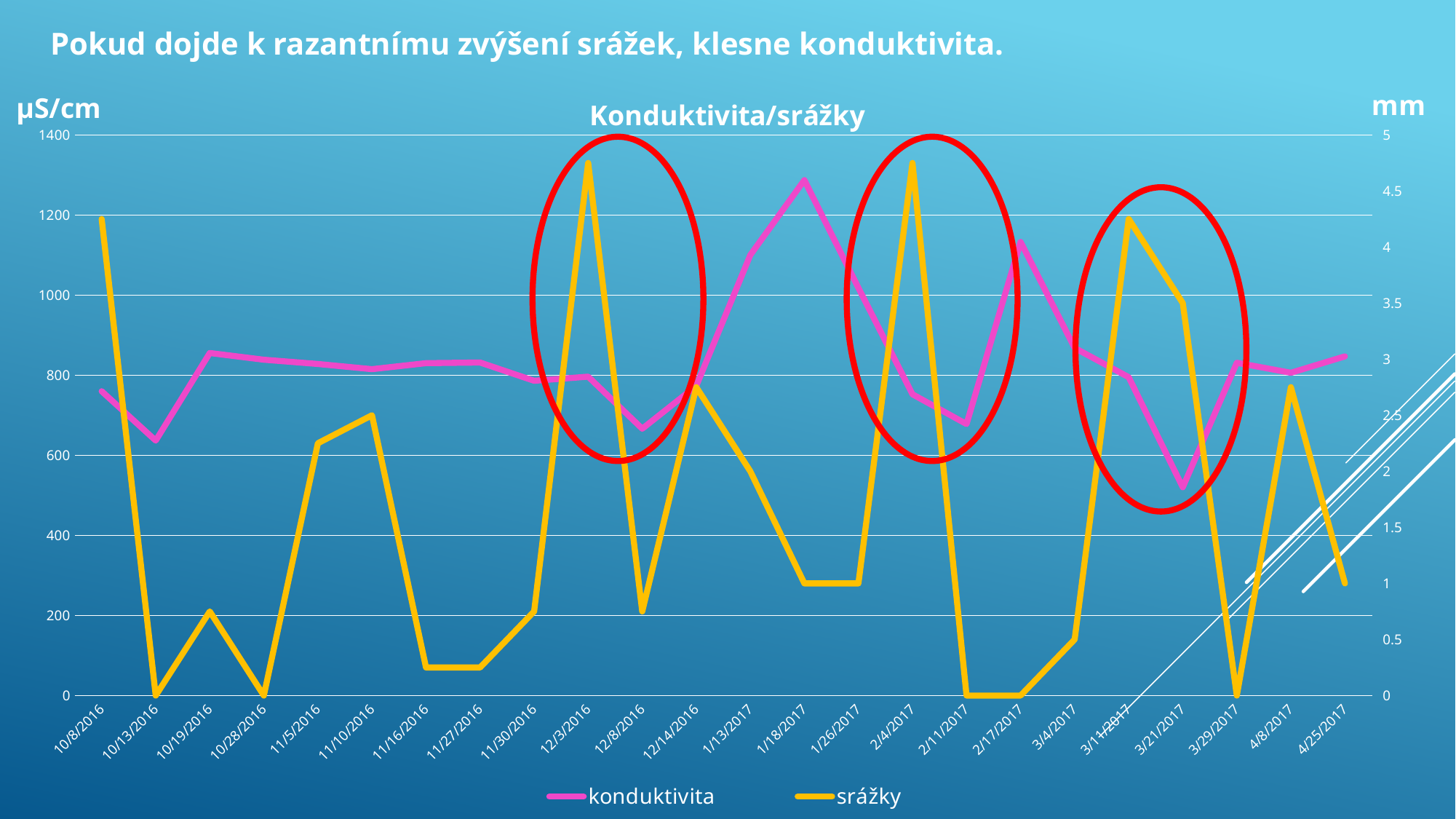
Is the konduktivita value on 1/18/2017 greater or less than 1200? greater Which is larger, the srážky value on 11/10/2016 or on 11/16/2016? 11/10/2016 What is the srážky value on 10/13/2016? 0 What is the title of the chart? Konduktivita/srážky What kind of chart is shown on the slide? line chart What is the srážky value on 3/29/2017? 0 How many dates are plotted along the x axis? 24 What unit is shown on the left vertical axis? µS/cm Is the konduktivita value on 3/21/2017 greater or less than 600? less How many series does the legend list? 2 On which date does konduktivita reach its lowest value? 3/21/2017 On which date does konduktivita reach its highest value? 1/18/2017